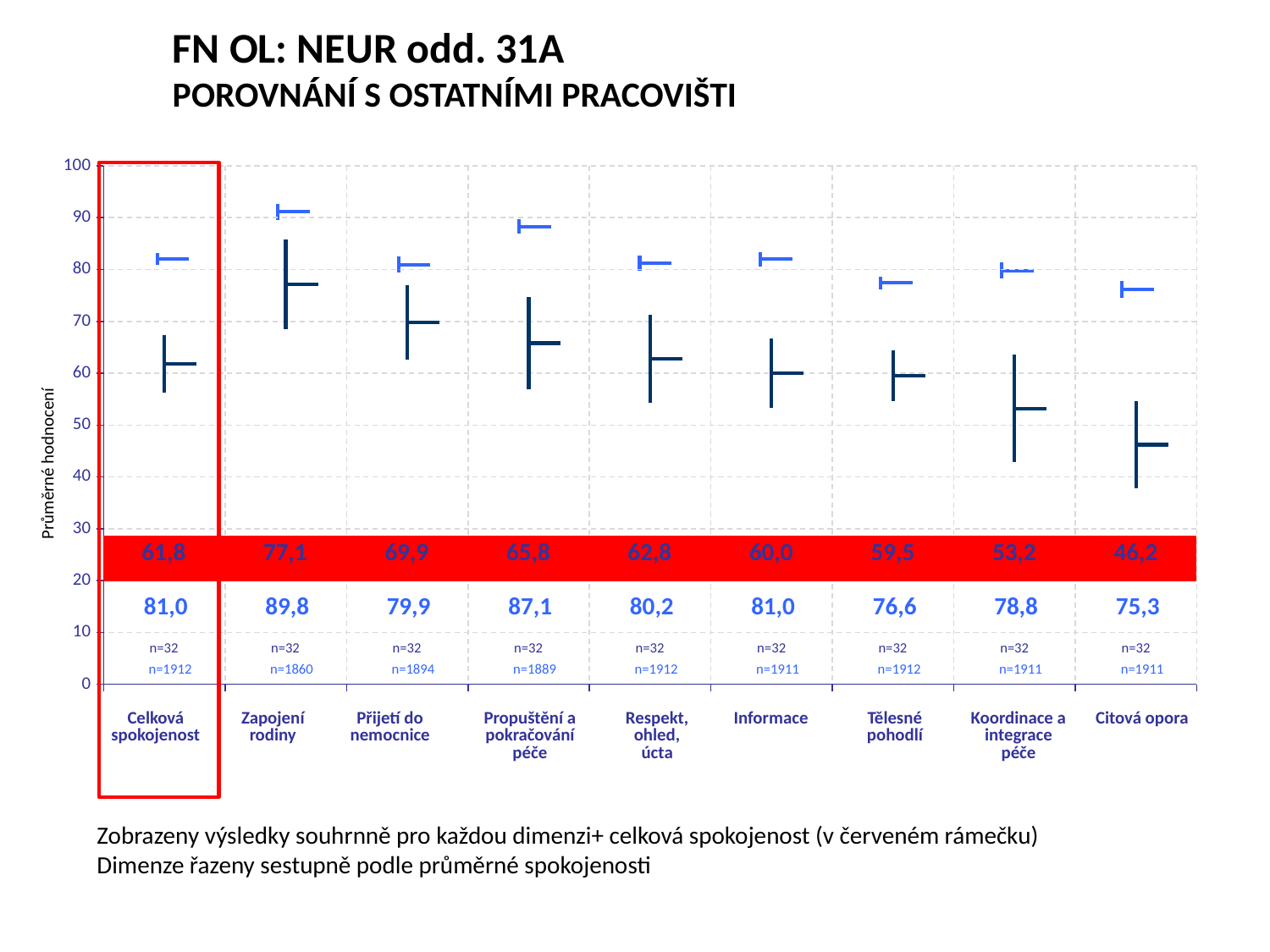
How many categories are shown along the x axis? 9 What is the department's value (red band) for Celková spokojenost? 61,8 Which is larger for Informace: the red-band value or the comparison value? the comparison value (81,0) What is the difference between the red-band values for Zapojení rodiny and Koordinace a integrace péče? 23,9 What is the comparison value (lower row) for Propuštění a pokračování péče? 87,1 Is the red-band value for Tělesné pohodlí greater or less than 60? less What is the sample size n for the department in each category? n=32 Which category has the highest value in the lower (comparison) row? Zapojení rodiny Which dimension has the highest value in the red band? Zapojení rodiny What is the department's value (red band) for Zapojení rodiny? 77,1 What is the difference between the comparison value and the red-band value for Citová opora? 29,1 Which dimension has the lowest value in the red band? Citová opora